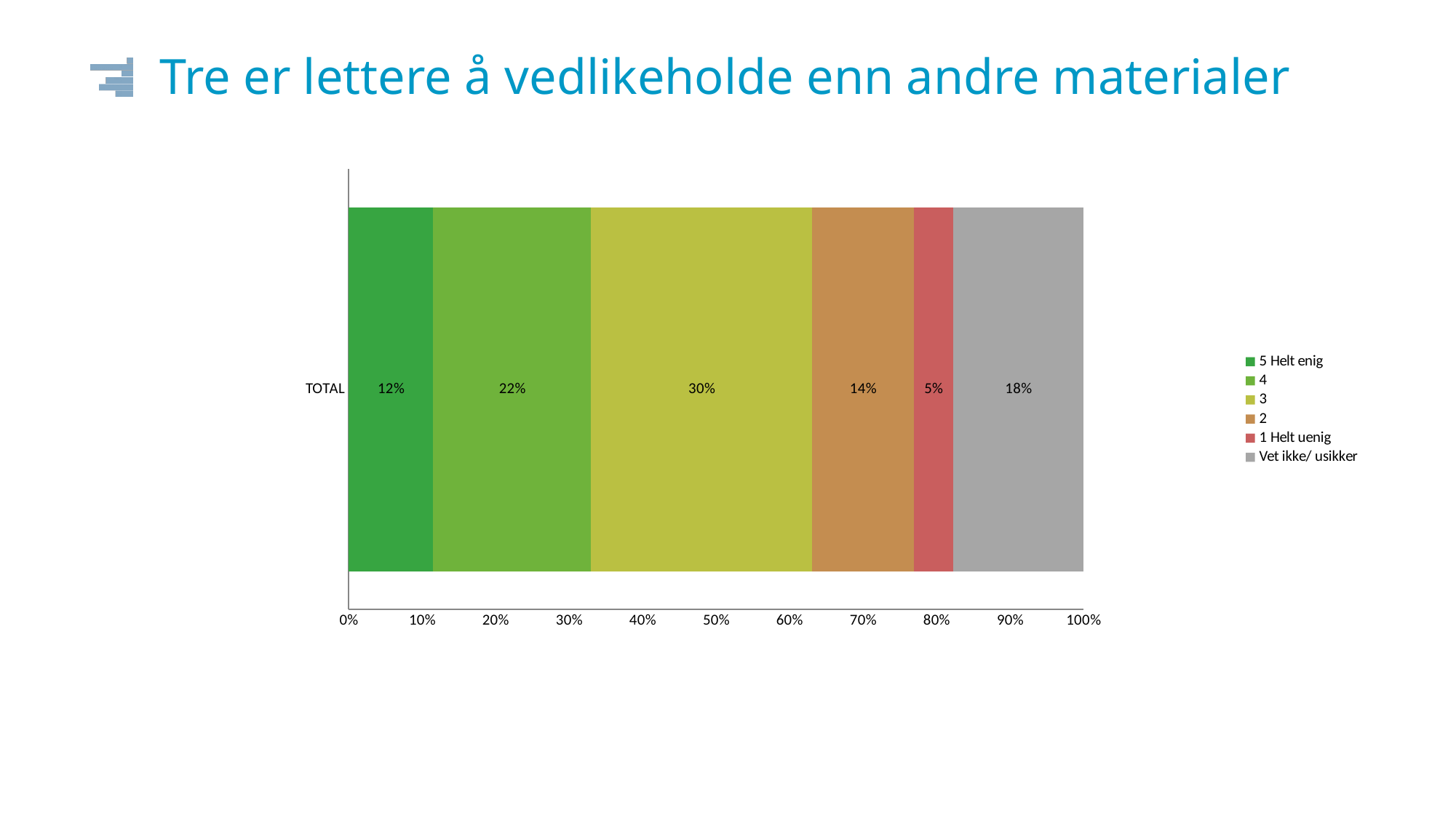
What kind of chart is shown on the slide? Stacked bar chart What percentage of respondents answered 'Vet ikke/ usikker'? 18% Which is larger: the share answering '5 Helt enig' or the share answering 'Vet ikke/ usikker'? Vet ikke/ usikker What is the difference between the share answering '4' and the share answering '2'? 8% What percentage of respondents answered '1 Helt uenig'? 5% How many series does the legend list? 6 What percentage of respondents answered '5 Helt enig'? 12% What percentage of respondents answered '3'? 30% Which response category has the largest share of the TOTAL bar? 3 What is the title of the slide? Tre er lettere å vedlikeholde enn andre materialer Which response category has the smallest share of the TOTAL bar? 1 Helt uenig What is the combined share of respondents answering '5 Helt enig' and '4'? 34%